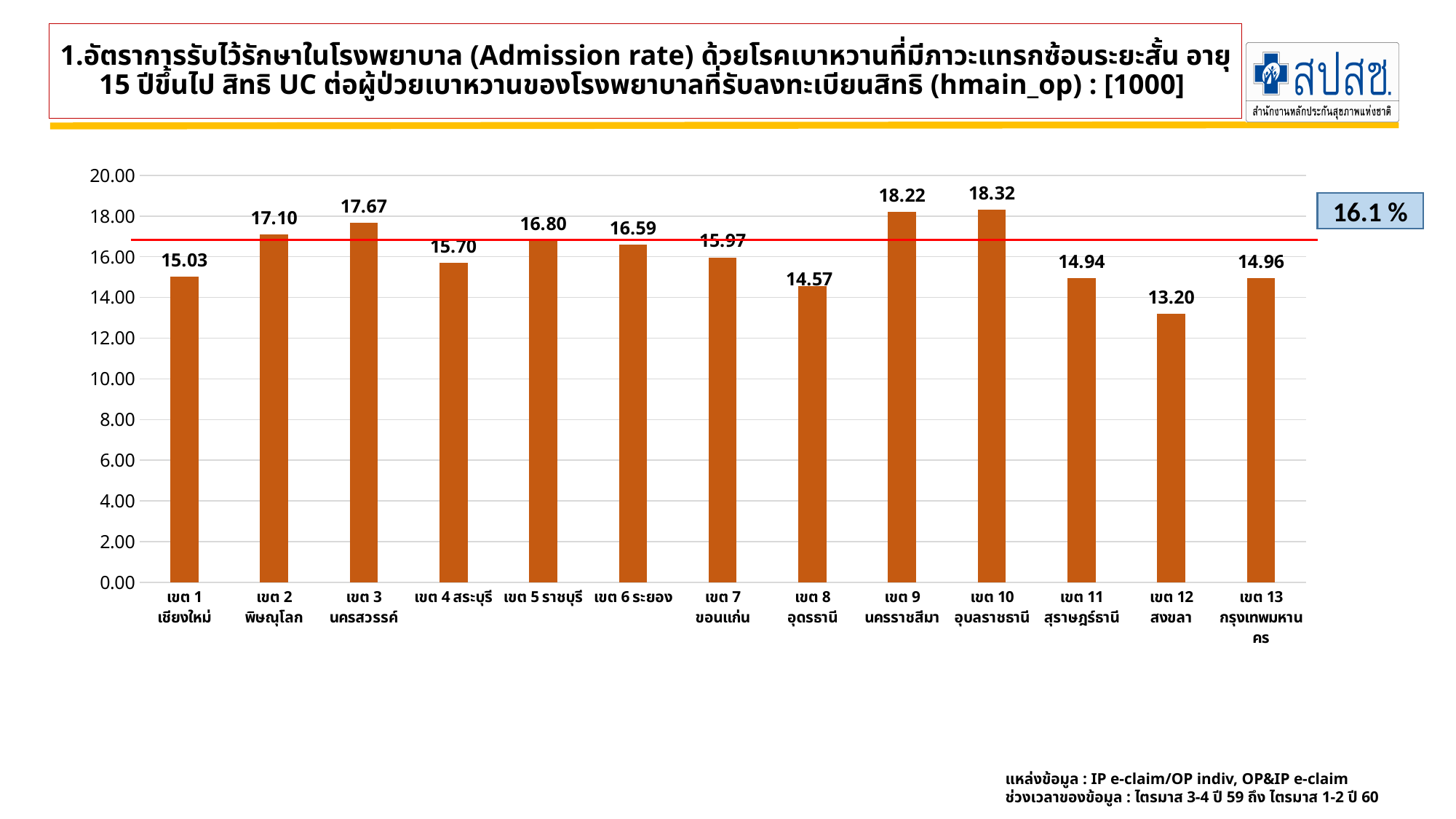
How many regions (เขต) are shown on the x axis? 13 What is the value for เขต 12 สงขลา? 13.20 What value is shown in the box next to the red horizontal reference line? 16.1 % What is the difference between the values for เขต 10 อุบลราชธานี and เขต 12 สงขลา? 5.12 Which region has the lowest value? เขต 12 สงขลา What is the value for เขต 1 เชียงใหม่? 15.03 Is the value for เขต 5 ราชบุรี greater or less than 16.00? greater What kind of chart is shown on the slide? bar chart Which region has the highest value? เขต 10 อุบลราชธานี What is the difference between the values for เขต 3 นครสวรรค์ and เขต 2 พิษณุโลก? 0.57 What is the value for เขต 10 อุบลราชธานี? 18.32 Which is larger, the value for เขต 9 นครราชสีมา or เขต 8 อุดรธานี? เขต 9 นครราชสีมา